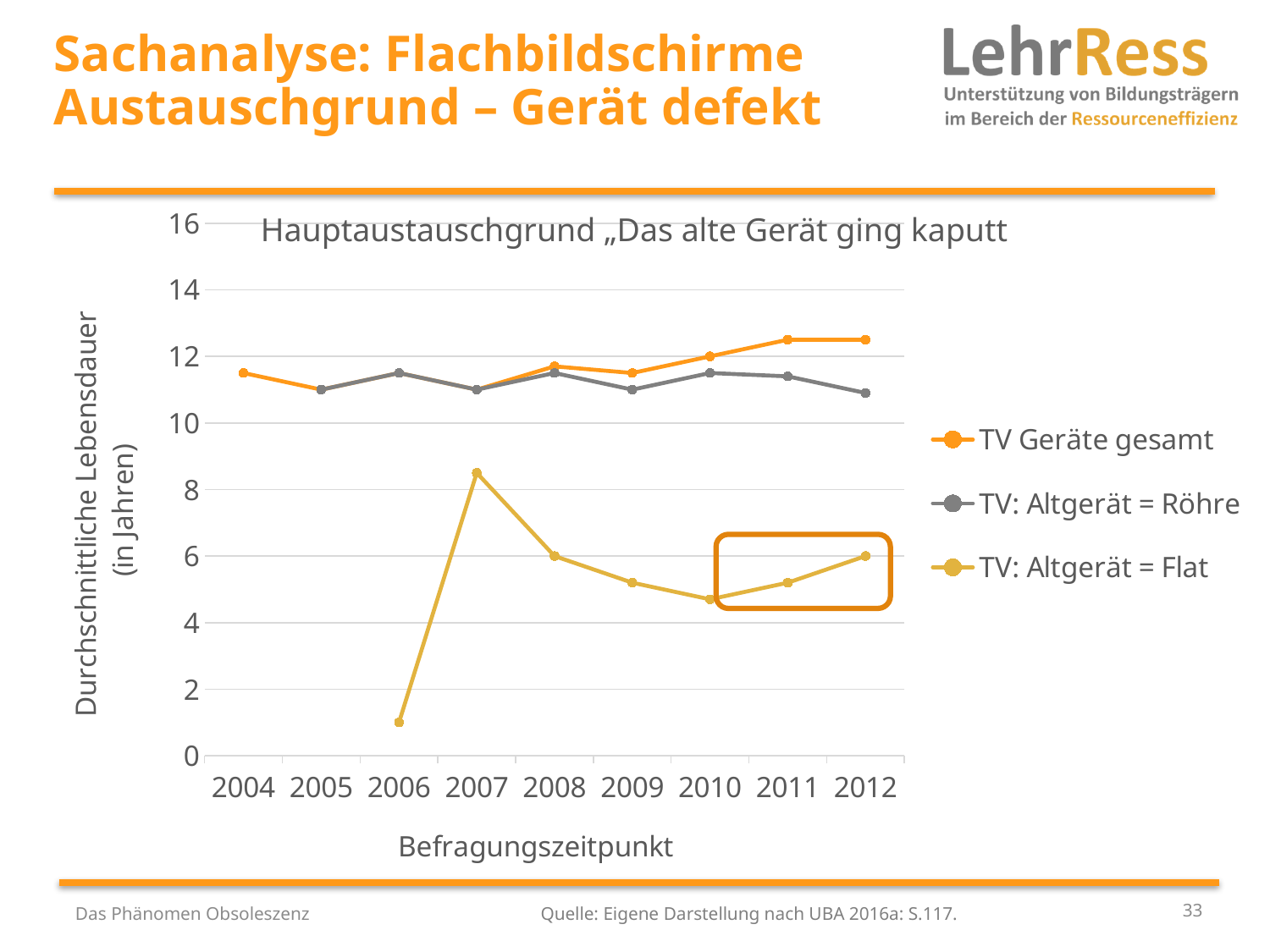
How many years are shown on the x axis? 9 What is the label of the x axis? Befragungszeitpunkt What kind of chart is shown on the slide? line chart Is the value for TV: Altgerät = Flat in 2006 greater or less than 2? less In which year is the value for TV: Altgerät = Flat highest? 2007 In 2012, which series has the larger value: TV Geräte gesamt or TV: Altgerät = Röhre? TV Geräte gesamt How many series does the legend list? 3 Is the value for TV: Altgerät = Röhre in 2012 greater or less than 12? less Is the value for TV Geräte gesamt in 2012 greater or less than 12? greater Does the value for TV Geräte gesamt rise or fall from 2009 to 2012? rise In which year is the value for TV: Altgerät = Flat lowest? 2006